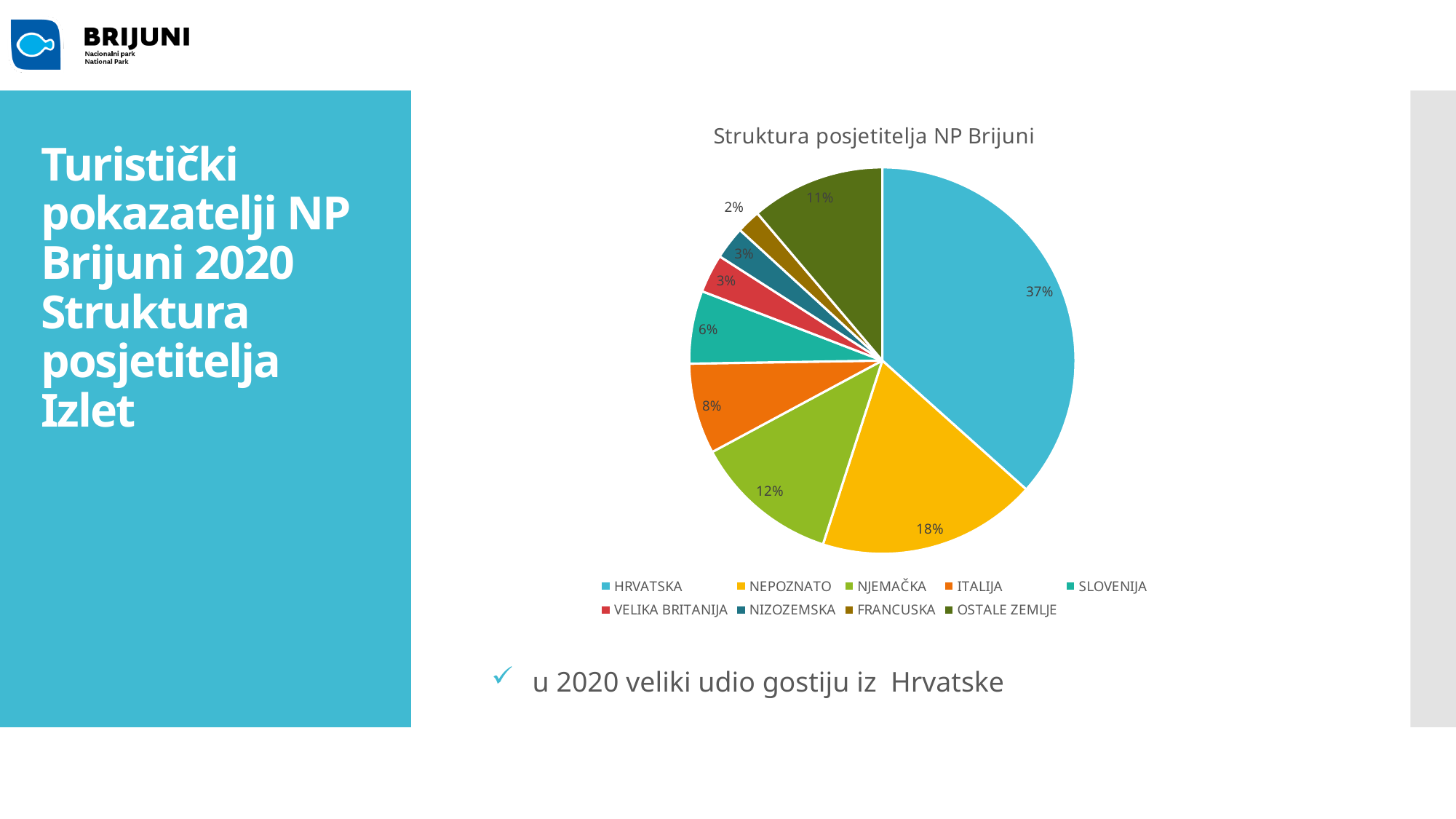
What share of the pie does ITALIJA have? 8% What is the difference in percentage points between HRVATSKA and NEPOZNATO? 19 How many categories does the pie chart show? 9 What is the title of the chart? Struktura posjetitelja NP Brijuni What share of the pie does OSTALE ZEMLJE have? 11% Which category has the smallest slice of the pie? FRANCUSKA What share of the pie does NEPOZNATO have? 18% Which is larger, the share for SLOVENIJA or the share for ITALIJA? ITALIJA Which category has the largest slice of the pie? HRVATSKA